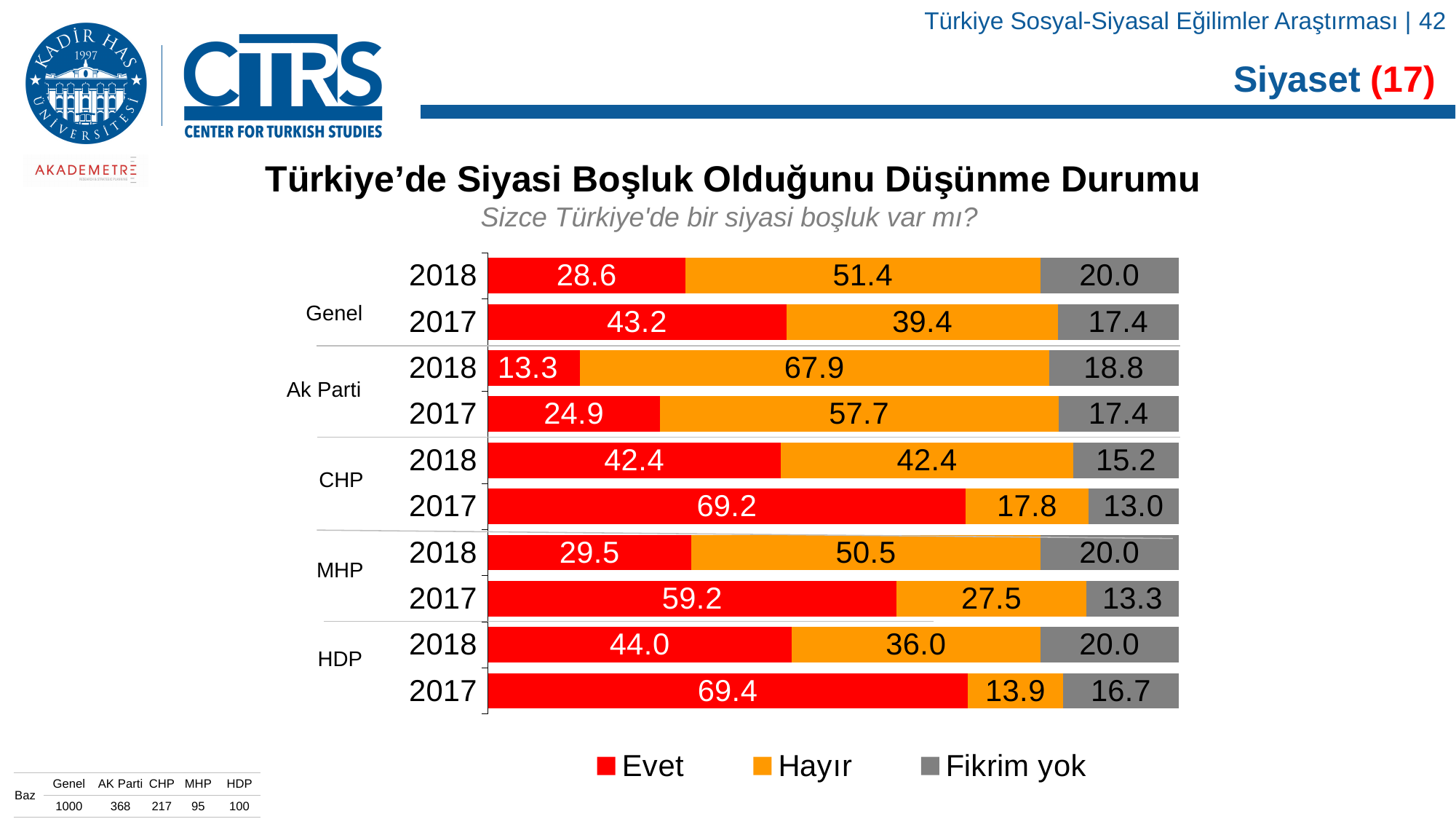
What is the total of the Genel 2017 bar? 100.0 What kind of chart is shown? Stacked bar chart What is the Hayır value for Ak Parti in 2018? 67.9 Which colour represents Fikrim yok in the legend? Grey Which is larger for MHP in 2018: Evet or Hayır? Hayır What is the difference between the Evet values for CHP in 2017 and 2018? 26.8 How many series does the legend list? 3 What is the Fikrim yok value for HDP in 2017? 16.7 Which group and year has the highest Evet value? HDP 2017 What is the Evet value for Genel in 2018? 28.6 Which group and year has the lowest Evet value? Ak Parti 2018 How many bars are shown in the chart? 10